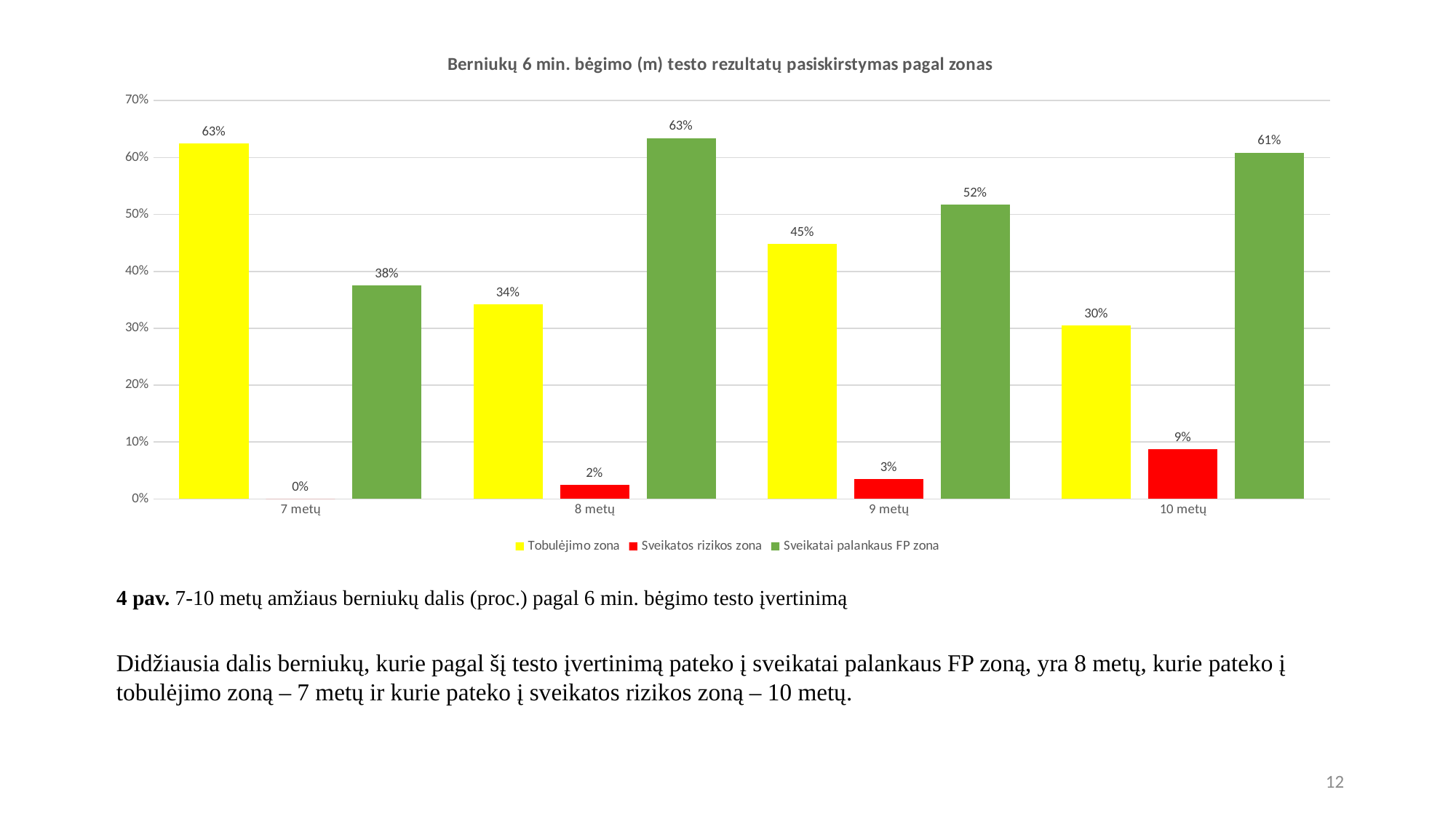
Which age group has the highest value for Sveikatos rizikos zona? 10 metų What is the value for Sveikatai palankaus FP zona at 8 metų? 63% What is the difference between Sveikatai palankaus FP zona and Tobulėjimo zona at 8 metų? 29% What is the value for Tobulėjimo zona at 9 metų? 45% Which age group has the lowest value for Sveikatai palankaus FP zona? 7 metų At 9 metų, which is larger: Tobulėjimo zona or Sveikatai palankaus FP zona? Sveikatai palankaus FP zona Does the value for Sveikatos rizikos zona rise or fall from 7 metų to 10 metų? rise What is the value for Tobulėjimo zona at 7 metų? 63% How many age groups are shown on the x axis? 4 What is the value for Sveikatos rizikos zona at 10 metų? 9% Which age group has the highest value for Tobulėjimo zona? 7 metų How many series does the legend list? 3